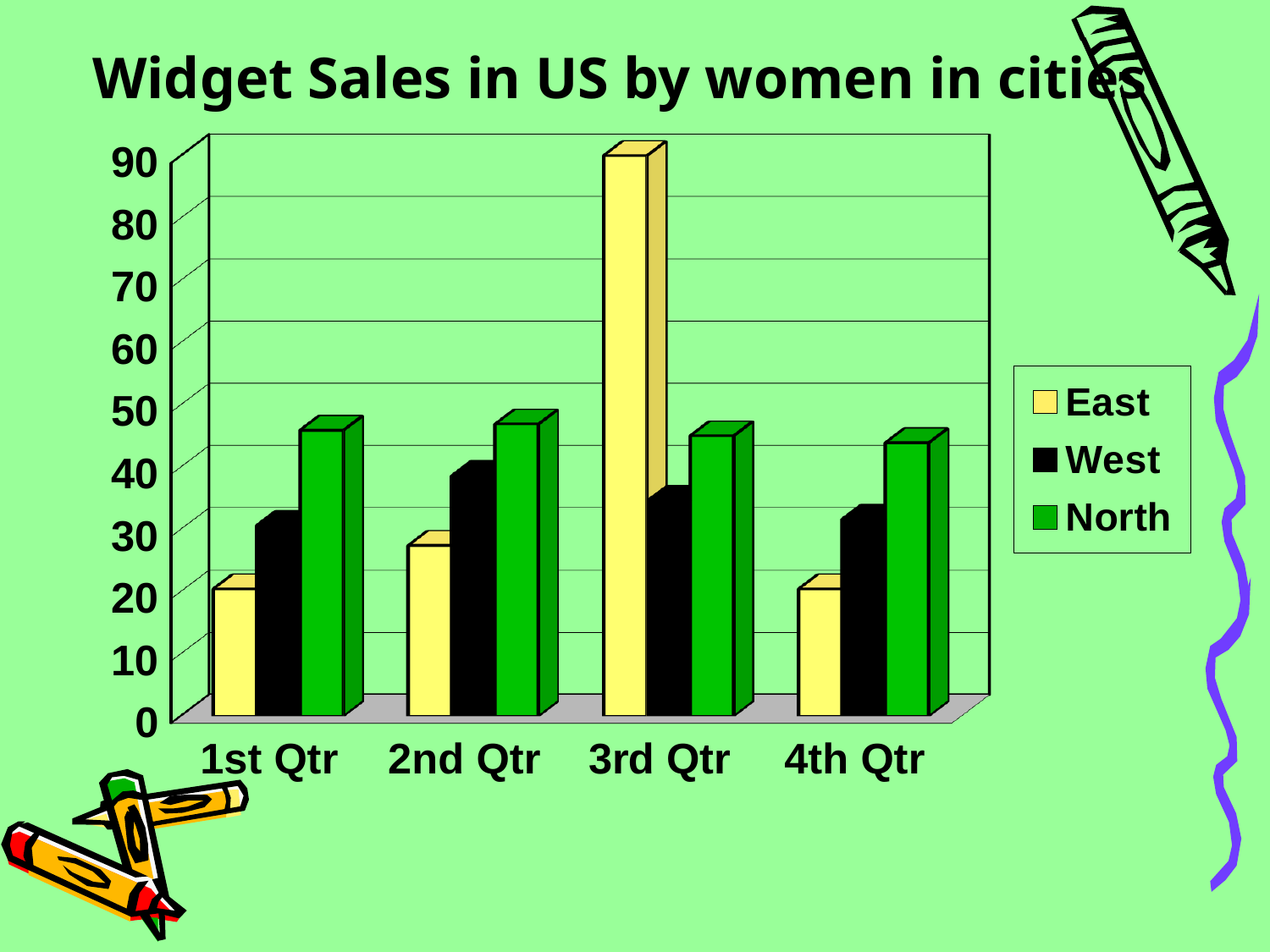
Is the value for North in 1st Qtr greater or less than 50? less How many quarters are shown on the x axis of the chart? 4 Is the value for East in 3rd Qtr greater or less than 80? greater What are the series names listed in the chart's legend? East, West, North How many series does the chart's legend list? 3 Is the value for West in 2nd Qtr greater or less than 30? greater In 3rd Qtr, which is larger, East or North? East What is the title of the chart? Widget Sales in US by women in cities What kind of chart is shown on the slide? bar chart In which quarter is the East series highest? 3rd Qtr In 1st Qtr, which is larger, East or North? North